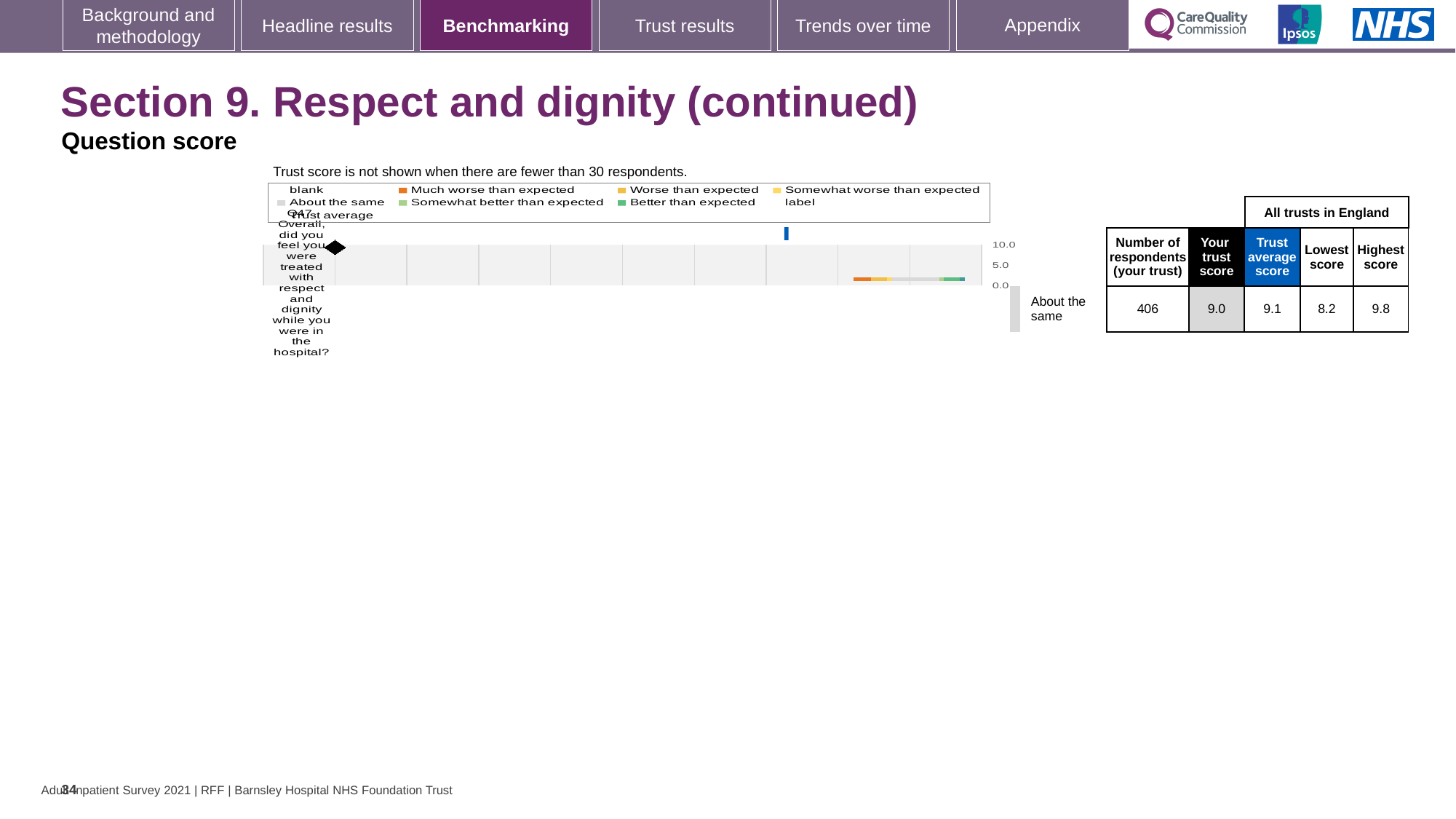
Which is larger for Q47, your trust score or the trust average score? Trust average score What is the difference between the trust average score and your trust score for Q47? 0.1 What is the difference between the highest score and the lowest score for Q47? 1.6 What is your trust score for Q47? 9.0 What is the number of respondents for your trust for Q47? 406 Which question is plotted on the chart? Q47 How many survey questions are plotted on the chart? 1 How is your trust's result for Q47 categorised relative to expectations? About the same What is the highest score among all trusts in England for Q47? 9.8 What is the trust average score for Q47? 9.1 What kind of chart is shown on the slide? bar chart What is the lowest score among all trusts in England for Q47? 8.2